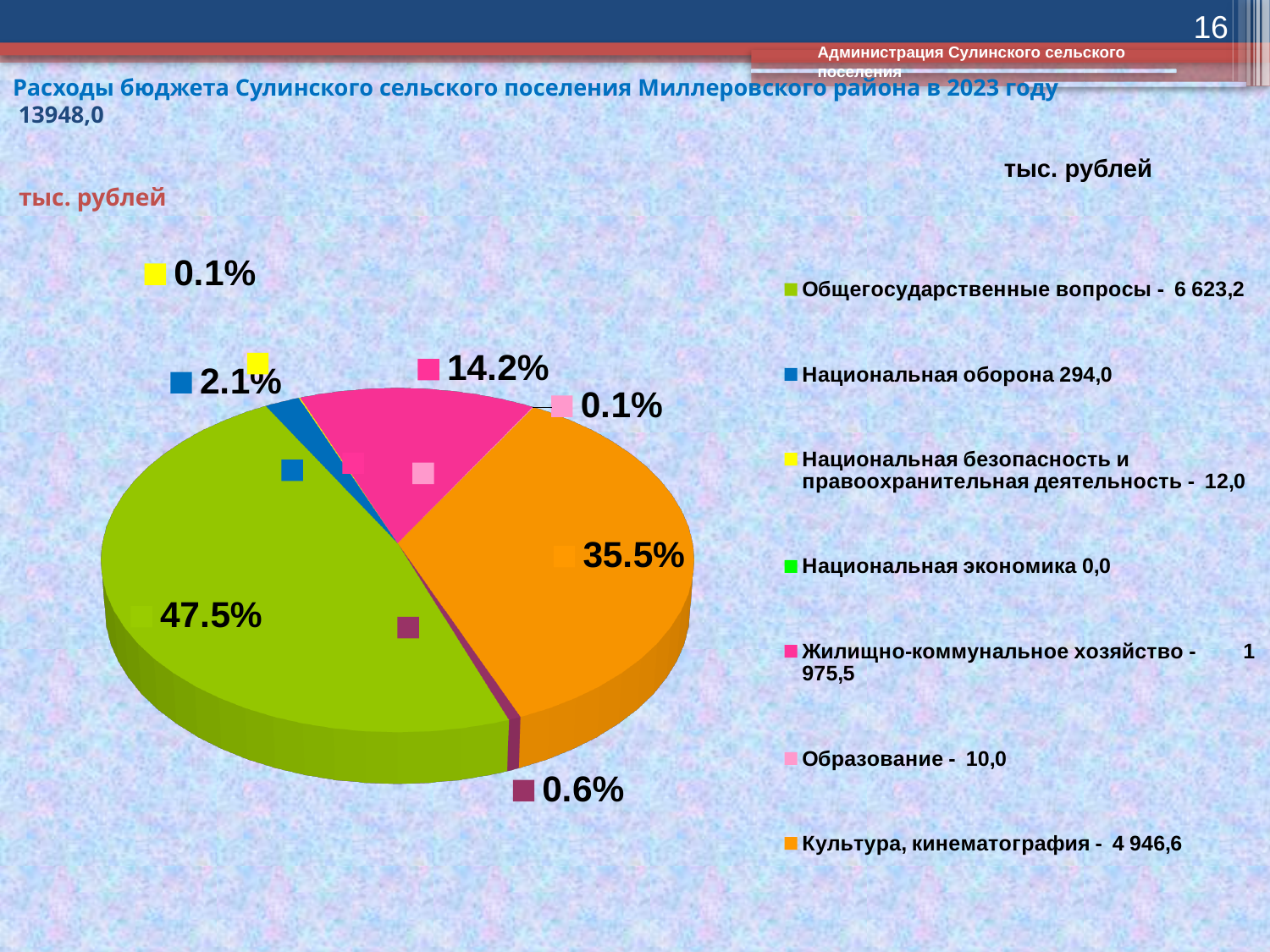
Which is larger: Культура, кинематография or Жилищно-коммунальное хозяйство? Культура, кинематография What is the difference between the values for Общегосударственные вопросы and Культура, кинематография (тыс. рублей)? 1 676,6 What share of the pie does Жилищно-коммунальное хозяйство take? 14.2% What total budget expenditure figure is stated in the slide title? 13948,0 What share of the pie does Национальная оборона take? 2.1% What kind of chart is shown on the slide? pie chart What value (тыс. рублей) is given in the legend for Общегосударственные вопросы? 6 623,2 What value (тыс. рублей) is given in the legend for Культура, кинематография? 4 946,6 What share of the pie does Культура, кинематография take? 35.5% How many entries does the legend list? 7 Which category has the largest share of the pie? Общегосударственные вопросы